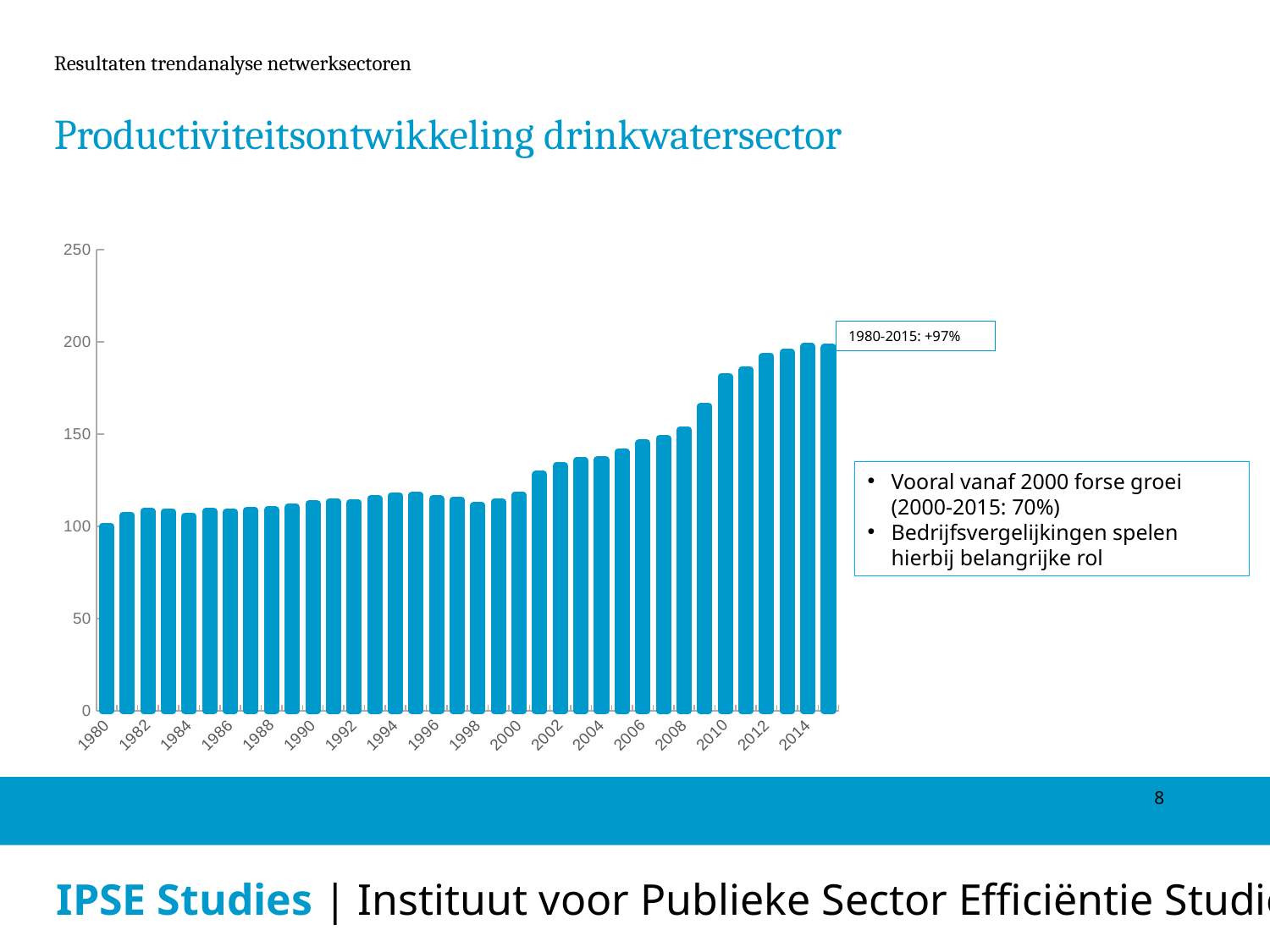
What growth percentage does the annotation on the chart give for 1980-2015? +97% Is the value for 2010 greater or less than 150? greater Do the values generally rise or fall from 1980 to 2015? rise Which year has the larger value, 2000 or 2010? 2010 Which year has the larger value, 1990 or 2005? 2005 Is the value for 1990 greater or less than 100? greater What is the title of the chart on the slide? Productiviteitsontwikkeling drinkwatersector How many bars (years) are plotted in the chart? 36 Which year has the lowest bar in the chart? 1980 What kind of chart is shown on the slide? bar chart Is the value for 2012 greater or less than 150? greater